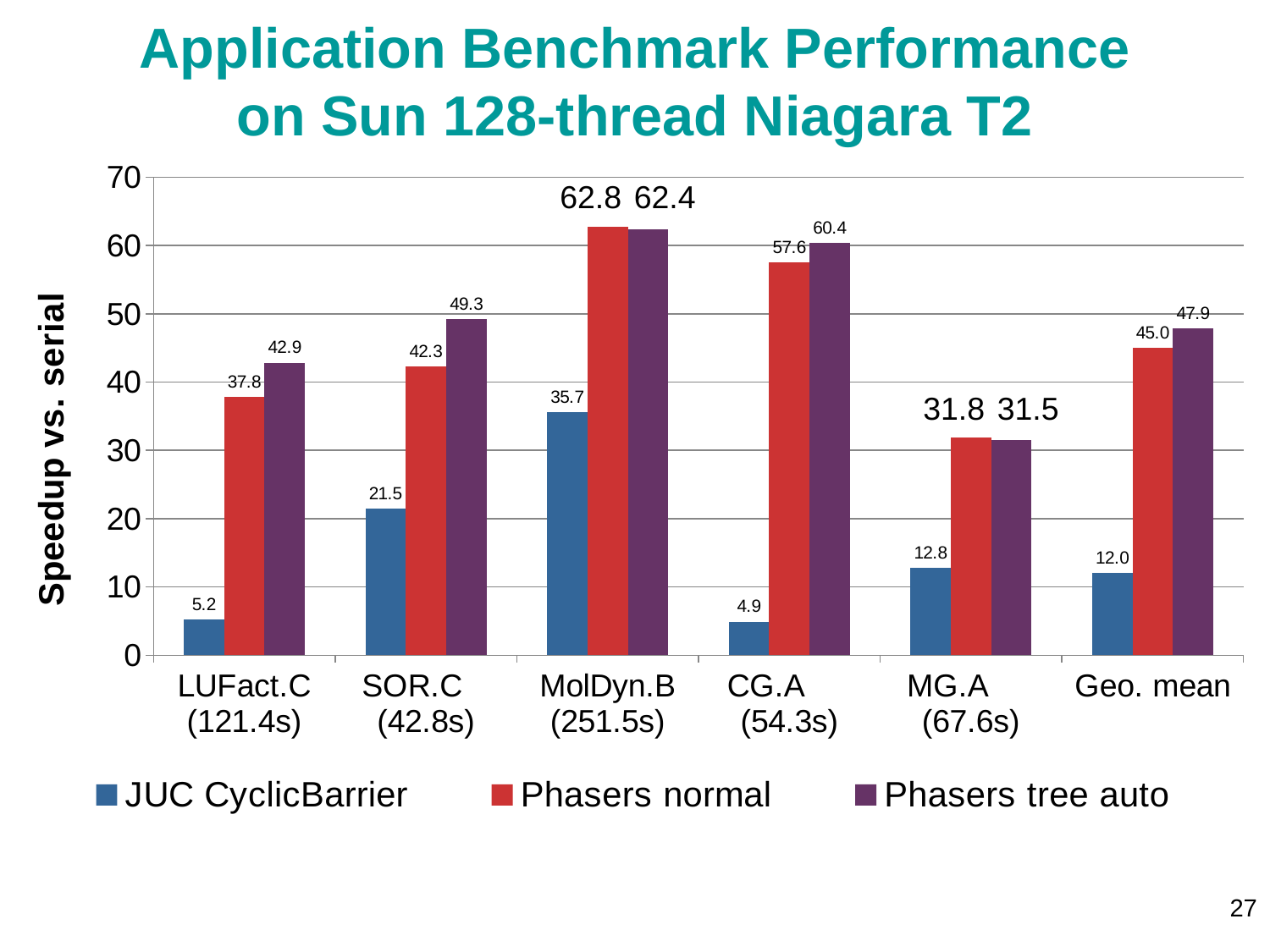
What is the label of the y axis? Speedup vs. serial What is the difference between the Phasers tree auto and JUC CyclicBarrier speedups on LUFact.C (121.4s)? 37.7 How many series does the legend list? 3 Which benchmark has the lowest speedup for JUC CyclicBarrier? CG.A (54.3s) What kind of chart is shown on the slide? bar chart Is the JUC CyclicBarrier speedup on SOR.C (42.8s) greater or less than 20? greater How many benchmark categories are shown on the x axis, including Geo. mean? 6 Which is larger on CG.A (54.3s): the Phasers normal speedup or the Phasers tree auto speedup? Phasers tree auto What is the Geo. mean speedup for Phasers normal? 45.0 What is the speedup for Phasers tree auto on SOR.C (42.8s)? 49.3 Which benchmark has the highest speedup for Phasers normal? MolDyn.B (251.5s) What is the speedup for JUC CyclicBarrier on MolDyn.B (251.5s)? 35.7